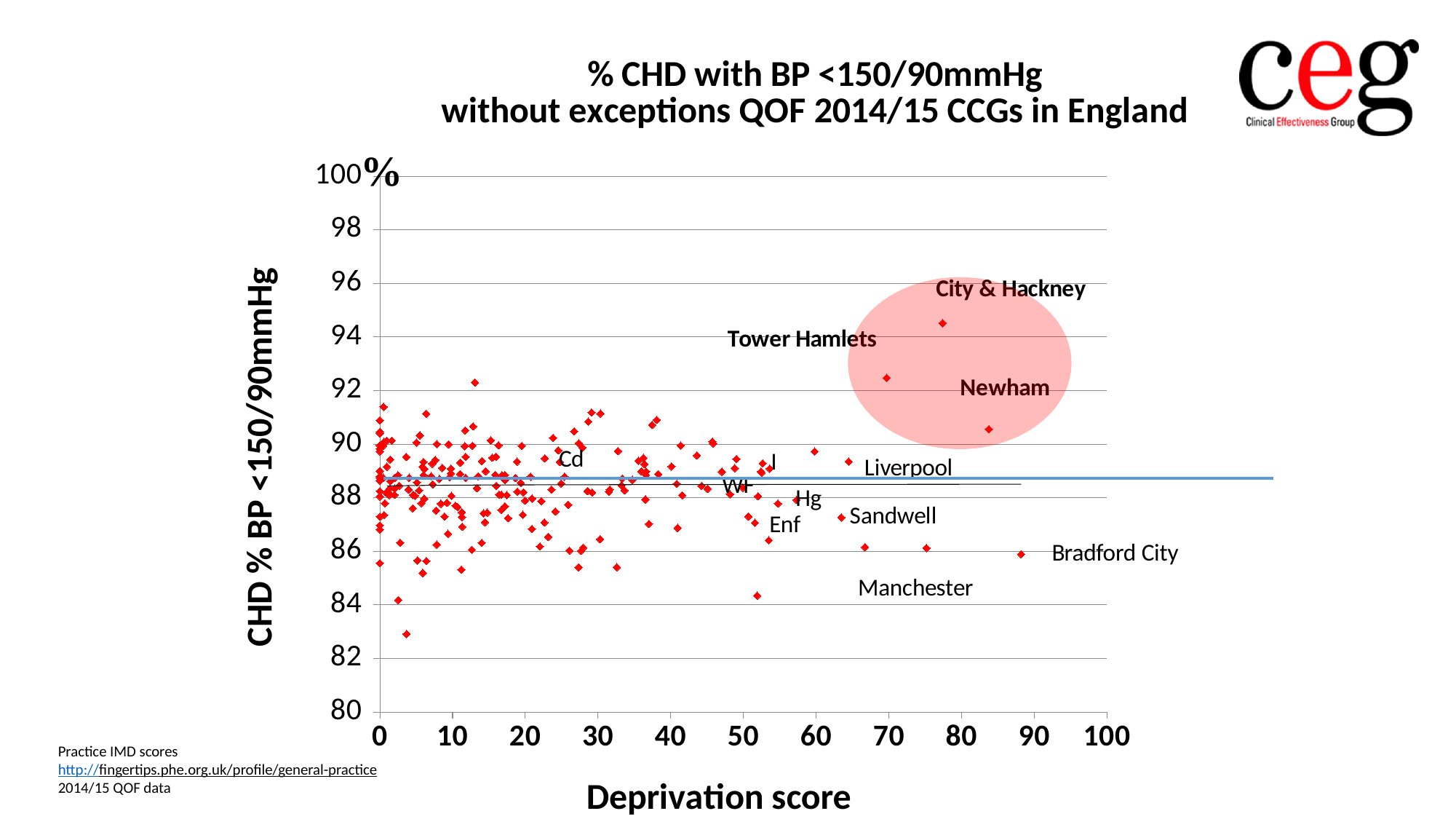
Is the value for Tower Hamlets greater or less than 92? greater Among the labelled CCGs, which has the highest value? City & Hackney Is the deprivation score for Bradford City greater or less than 80? greater Is the value for Sandwell greater or less than 88? less What kind of chart is shown on the slide? scatter chart Which has the higher value, City & Hackney or Newham? City & Hackney What is the title of the chart? % CHD with BP <150/90mmHg without exceptions QOF 2014/15 CCGs in England What is the label of the x axis? Deprivation score